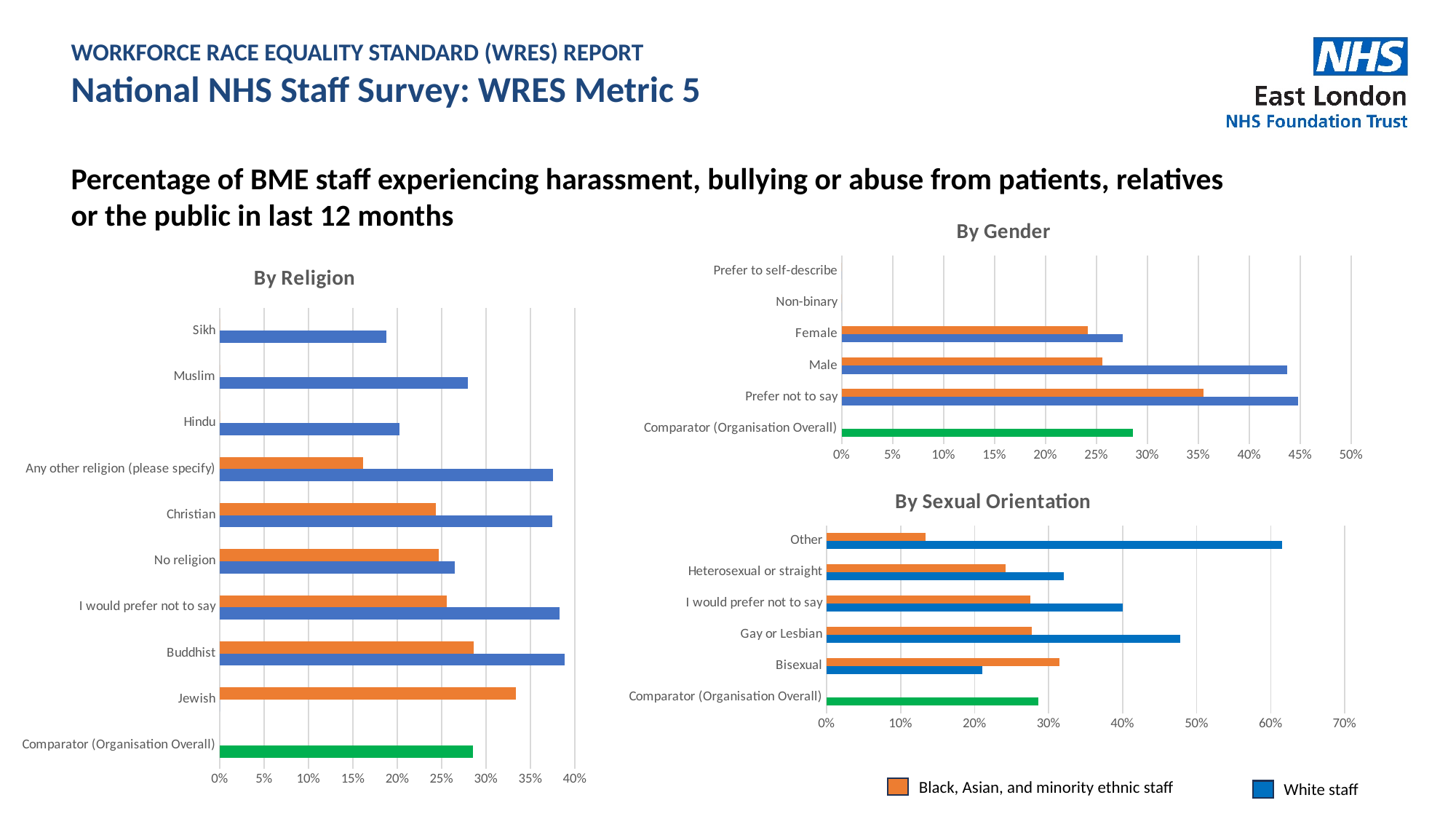
In the 'By Sexual Orientation' chart, for Bisexual staff, which is larger: the value for Black, Asian, and minority ethnic staff or for White staff? Black, Asian, and minority ethnic staff In the 'By Sexual Orientation' chart, which category has the lowest value for Black, Asian, and minority ethnic staff? Other In the 'By Religion' chart, is the value for Muslim White staff greater or less than 25%? greater In the 'By Sexual Orientation' chart, is the value for Other White staff greater or less than 50%? greater How many categories are listed on the y axis of the 'By Gender' chart? 6 In the 'By Gender' chart, which category has the highest value for Black, Asian, and minority ethnic staff? Prefer not to say How many series does the legend at the bottom of the slide list? 2 In the 'By Religion' chart, for Christian staff, which is larger: the value for White staff or for Black, Asian, and minority ethnic staff? White staff In the 'By Gender' chart, is the value for Male White staff greater or less than 40%? greater In the 'By Sexual Orientation' chart, which category has the highest value for White staff? Other What kind of chart is the 'By Religion' chart? bar chart